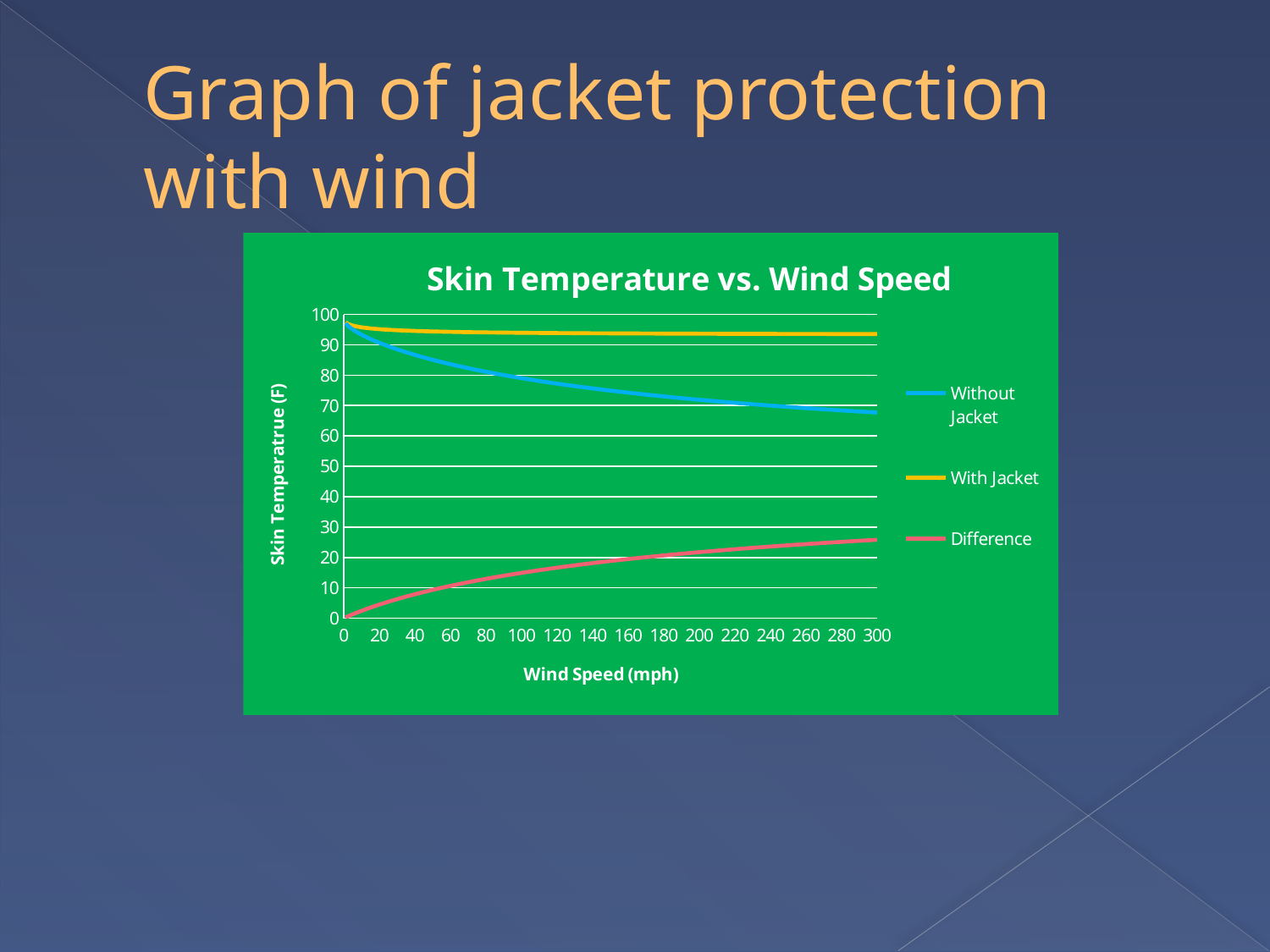
Is the value of the Difference line at 100 mph greater or less than 10? greater Is the value of the With Jacket line at 300 mph greater or less than 90? greater At 200 mph, which line is higher: With Jacket or Without Jacket? With Jacket Does the Difference line rise or fall as wind speed increases? Rise How many series does the legend list? 3 What is the label of the x axis? Wind Speed (mph) Is the value of the Difference line at 300 mph greater or less than 20? greater At 300 mph, which line is higher: Without Jacket or Difference? Without Jacket What is the title of the chart? Skin Temperature vs. Wind Speed What kind of chart is shown on the slide? Line chart Does the Without Jacket line rise or fall as wind speed increases? Fall